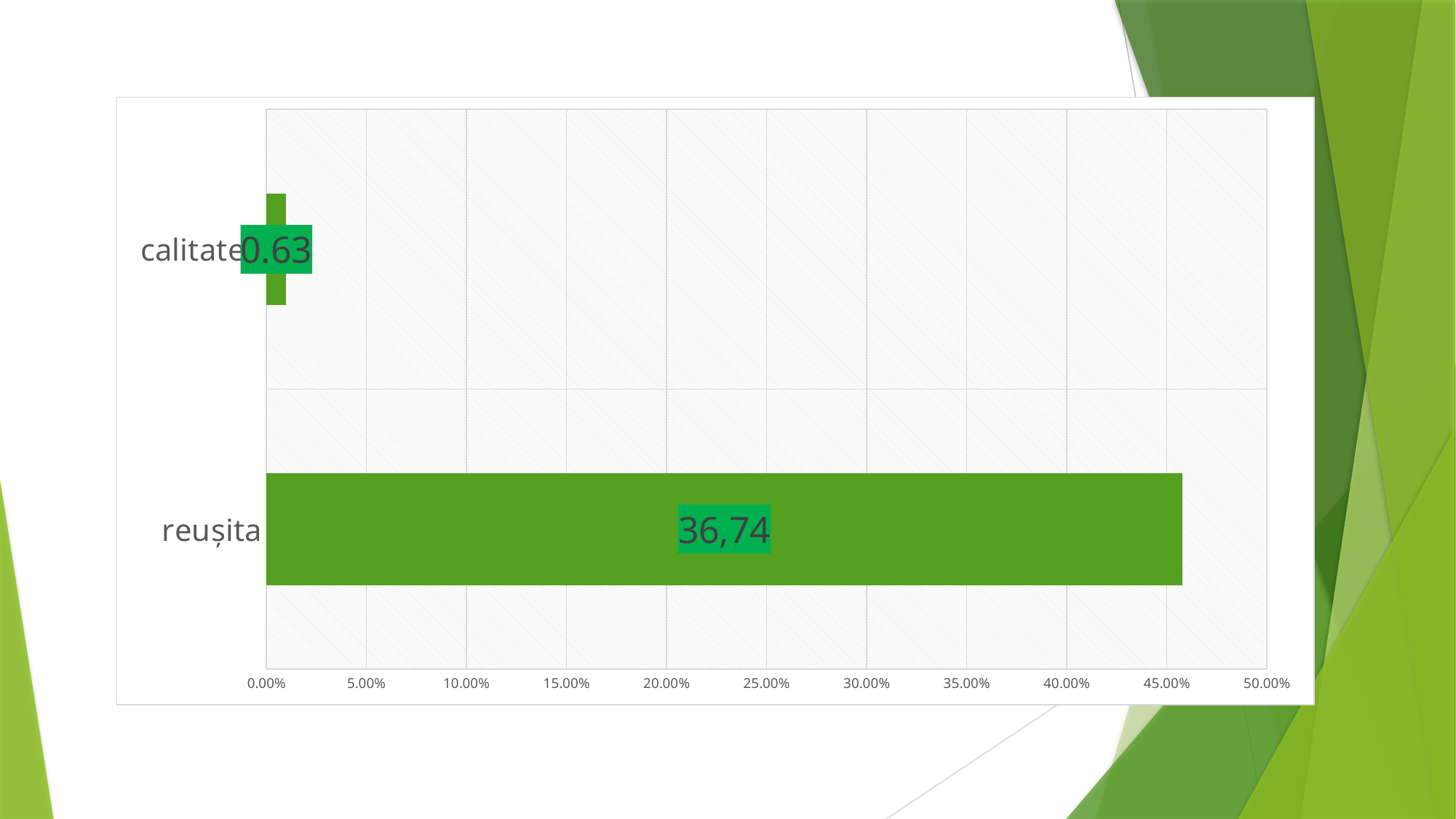
Which is larger, the value for reușita or the value for calitate? reușita What kind of chart is shown on the slide? bar chart What is the maximum value shown on the horizontal axis? 50.00% How many categories are plotted in the chart? 2 Which category has the lowest value? calitate What is the data label shown for reușita? 36,74 Which category has the highest value? reușita What is the data label shown for calitate? 0.63 What colour are the bars in the chart? green Is the bar for reușita greater or less than 40.00% on the axis? greater Is the bar for calitate greater or less than 5.00% on the axis? less